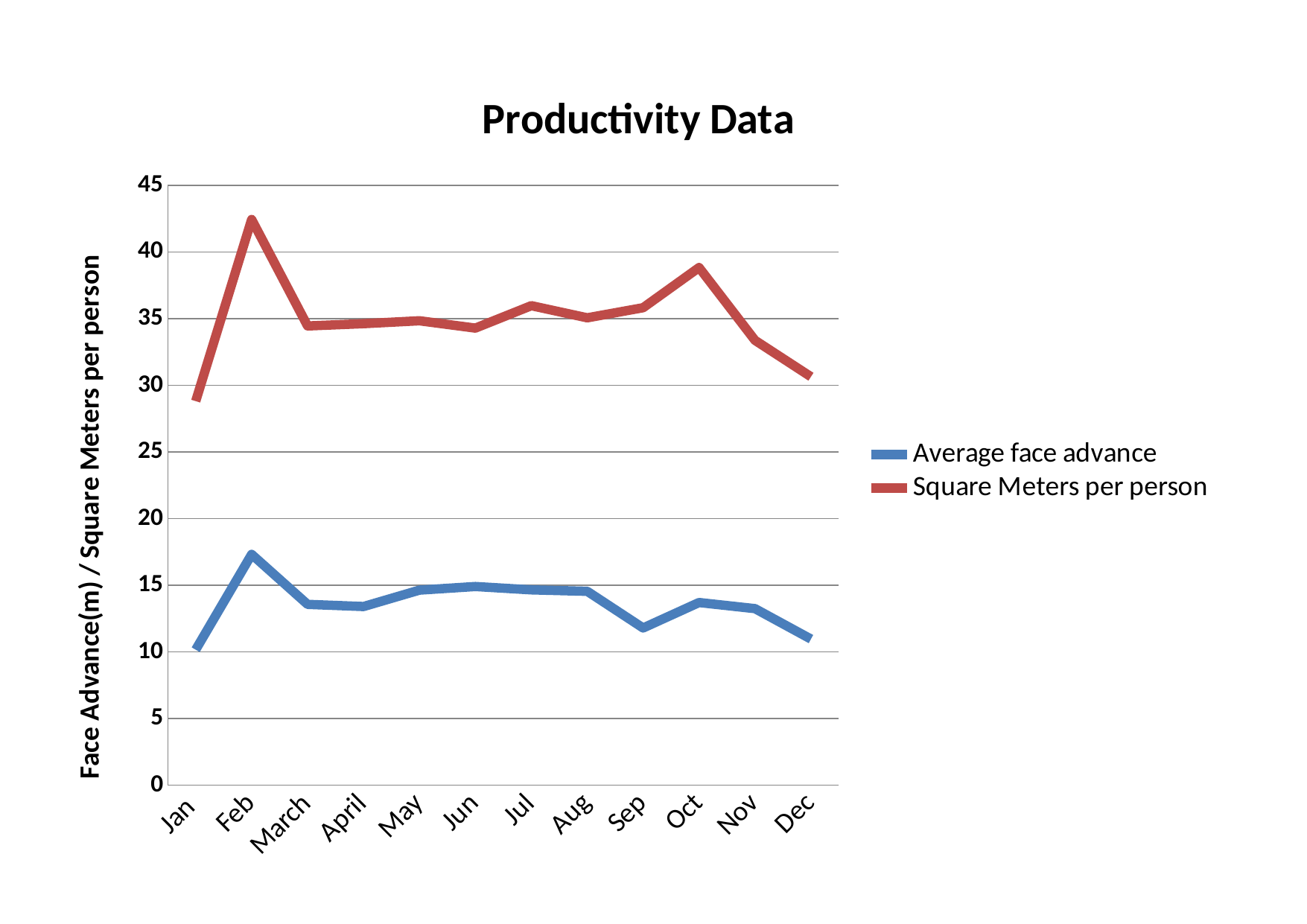
Is the value of Square Meters per person in Feb greater or less than 40? greater Is the value of Average face advance in Sep greater or less than 15? less How many months are plotted along the x axis? 12 How many series does the legend list? 2 Is the value of Square Meters per person in Oct greater or less than 35? greater In which month is Average face advance highest? Feb What is the title of the chart? Productivity Data Which is larger for Average face advance: the value in Jun or the value in Sep? Jun What type of chart is shown on the slide? Line chart In which month is Square Meters per person lowest? Jan In which month is Square Meters per person highest? Feb Does Square Meters per person rise or fall from Oct to Dec? Fall